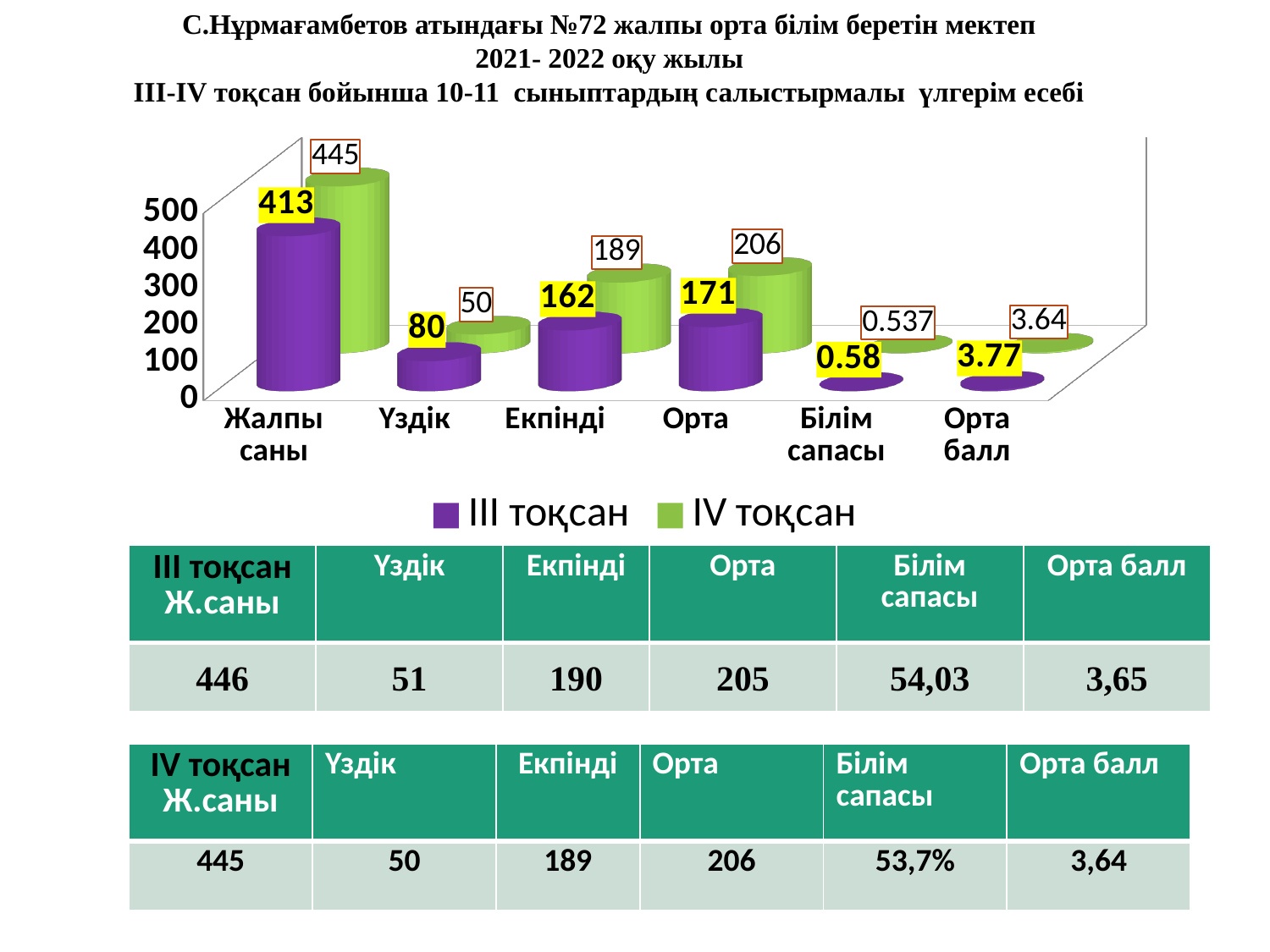
What is the value for Орта балл in the IV тоқсан series? 3.64 What is the value for Үздік in the IV тоқсан series? 50 What type of chart is shown on the slide? bar chart Which category has the highest value in the IV тоқсан series? Жалпы саны What is the value for Білім сапасы in the III тоқсан series? 0.58 What is the value for Жалпы саны in the IV тоқсан series? 445 Which series is shown in green in the chart? IV тоқсан How many series does the chart legend list? 2 Which is larger for Үздік: the III тоқсан value or the IV тоқсан value? III тоқсан How many categories are shown on the x axis of the chart? 6 What is the difference between the IV тоқсан and III тоқсан values for Орта? 35 What is the value for Жалпы саны in the III тоқсан series? 413